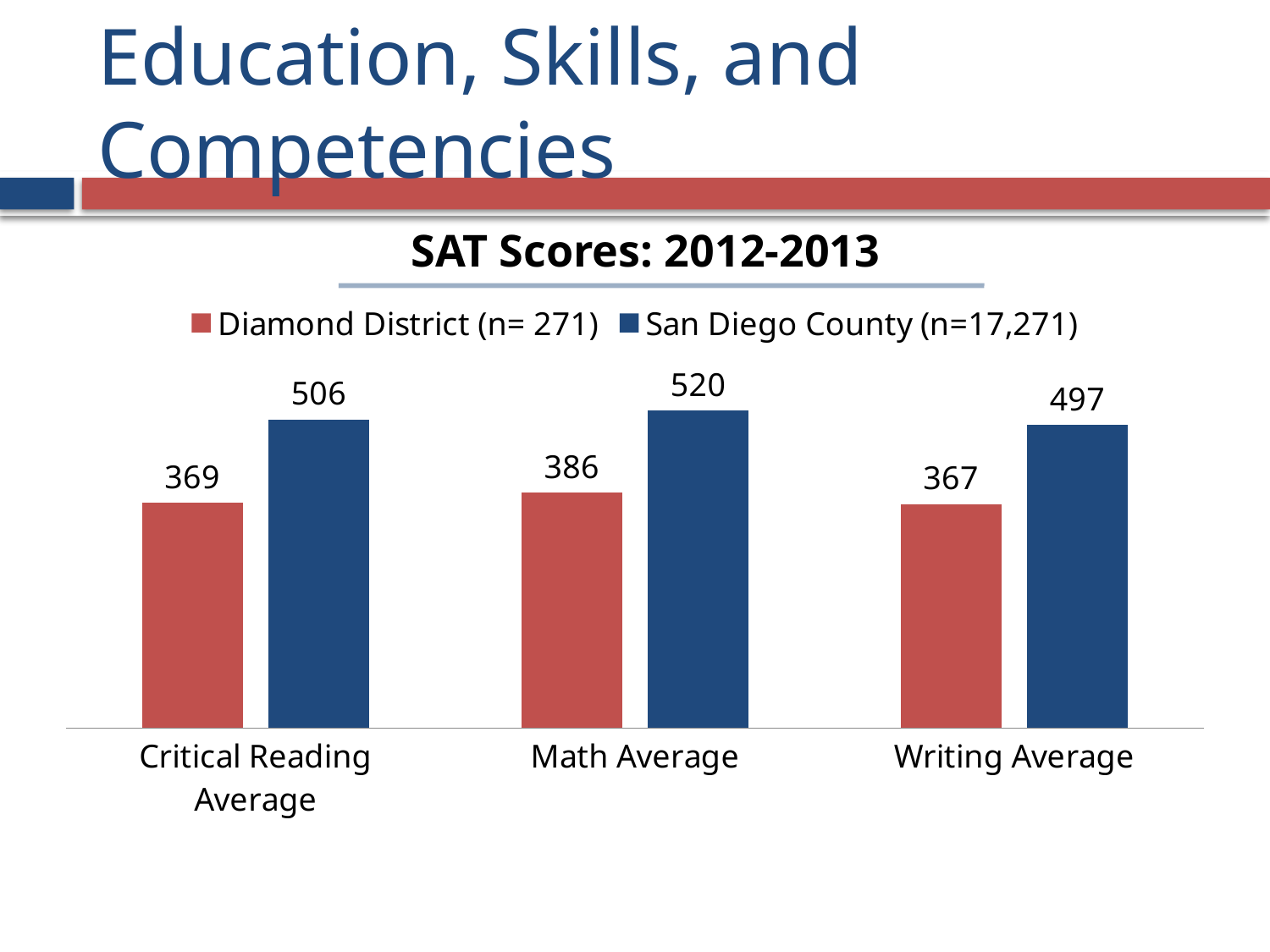
Which category has the highest San Diego County score? Math Average Which is larger, the Diamond District Math Average or the Diamond District Critical Reading Average? Diamond District Math Average How many categories are shown on the x axis? 3 What is the title of the chart? SAT Scores: 2012-2013 What kind of chart is shown on the slide? Bar chart What is the Diamond District Critical Reading Average SAT score? 369 What is the San Diego County Math Average SAT score? 520 What is the difference between the San Diego County and Diamond District Math Average scores? 134 How many series does the legend list? 2 What is the Diamond District Writing Average SAT score? 367 What is the San Diego County Writing Average SAT score? 497 Which category has the lowest Diamond District score? Writing Average